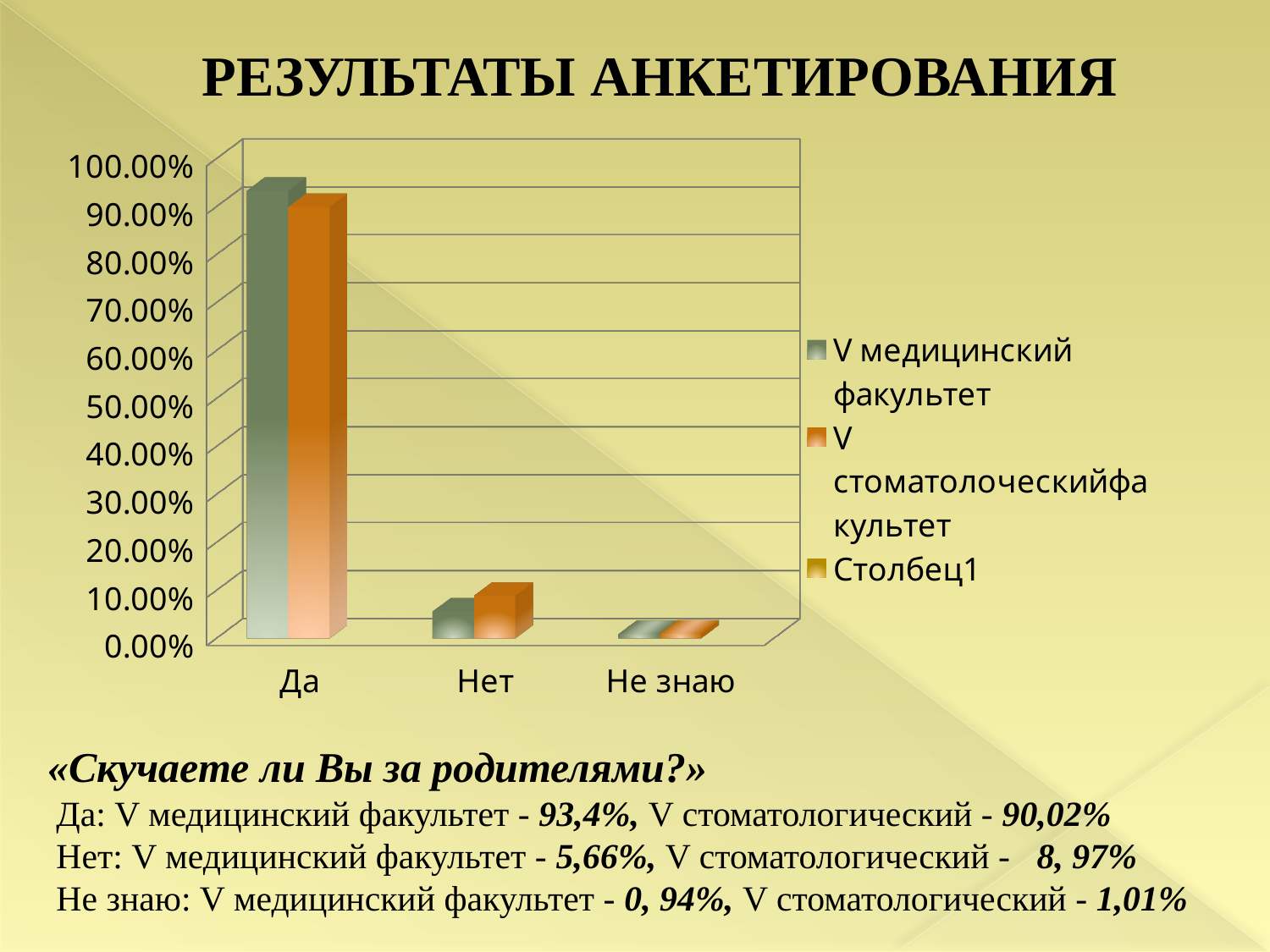
Which category has the lowest value for the V стоматологический series? Не знаю What is the value for "Да" for the V медицинский факультет series? 93,4% What is the value for "Да" for the V стоматологический series? 90,02% What is the value for "Нет" for the V стоматологический series? 8,97% Is the value for "Да" for the V медицинский факультет series greater or less than 90.00%? greater How many series does the chart legend list? 3 What is the difference between the V медицинский факультет and V стоматологический values for "Да"? 3,38% Which category has the highest value for the V медицинский факультет series? Да For the "Нет" category, which series has the larger value: V медицинский факультет or V стоматологический? V стоматологический What kind of chart is shown on the slide? bar chart How many categories are shown on the x axis of the chart? 3 What is the value for "Не знаю" for the V медицинский факультет series? 0,94%